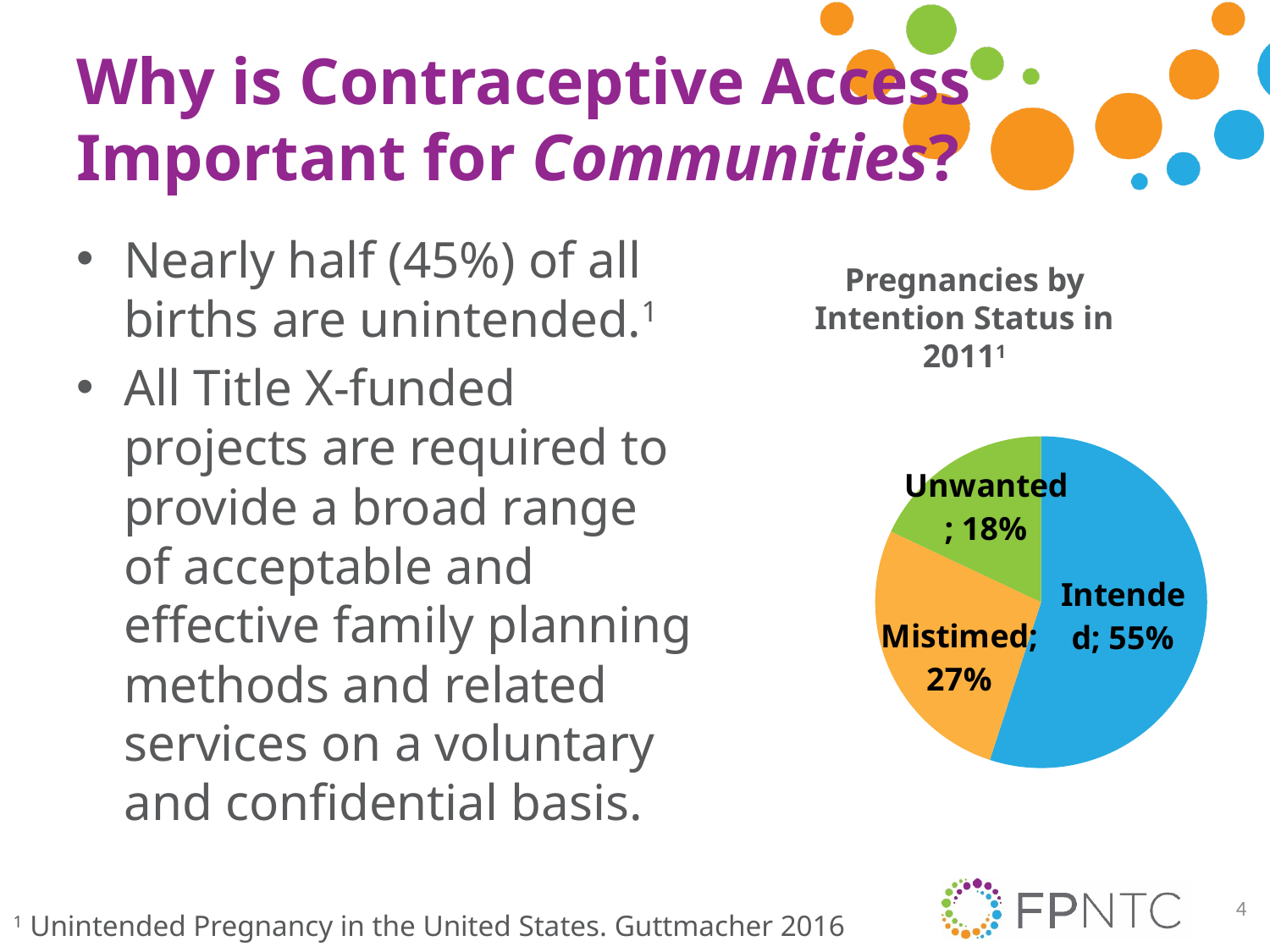
What is the title of the chart? Pregnancies by Intention Status in 2011 What colour is the Intended slice of the pie? Blue Which category has the largest share of the pie? Intended What is the difference in percentage points between Intended and Mistimed pregnancies? 28 Which is larger, the Mistimed share or the Unwanted share? Mistimed What percentage of pregnancies were Intended? 55% What type of chart is shown on the slide? Pie chart What percentage of pregnancies were Mistimed? 27% What is the difference in percentage points between Mistimed and Unwanted pregnancies? 9 What percentage of pregnancies were Unwanted? 18% Which category has the smallest share of the pie? Unwanted How many slices does the pie chart have? 3